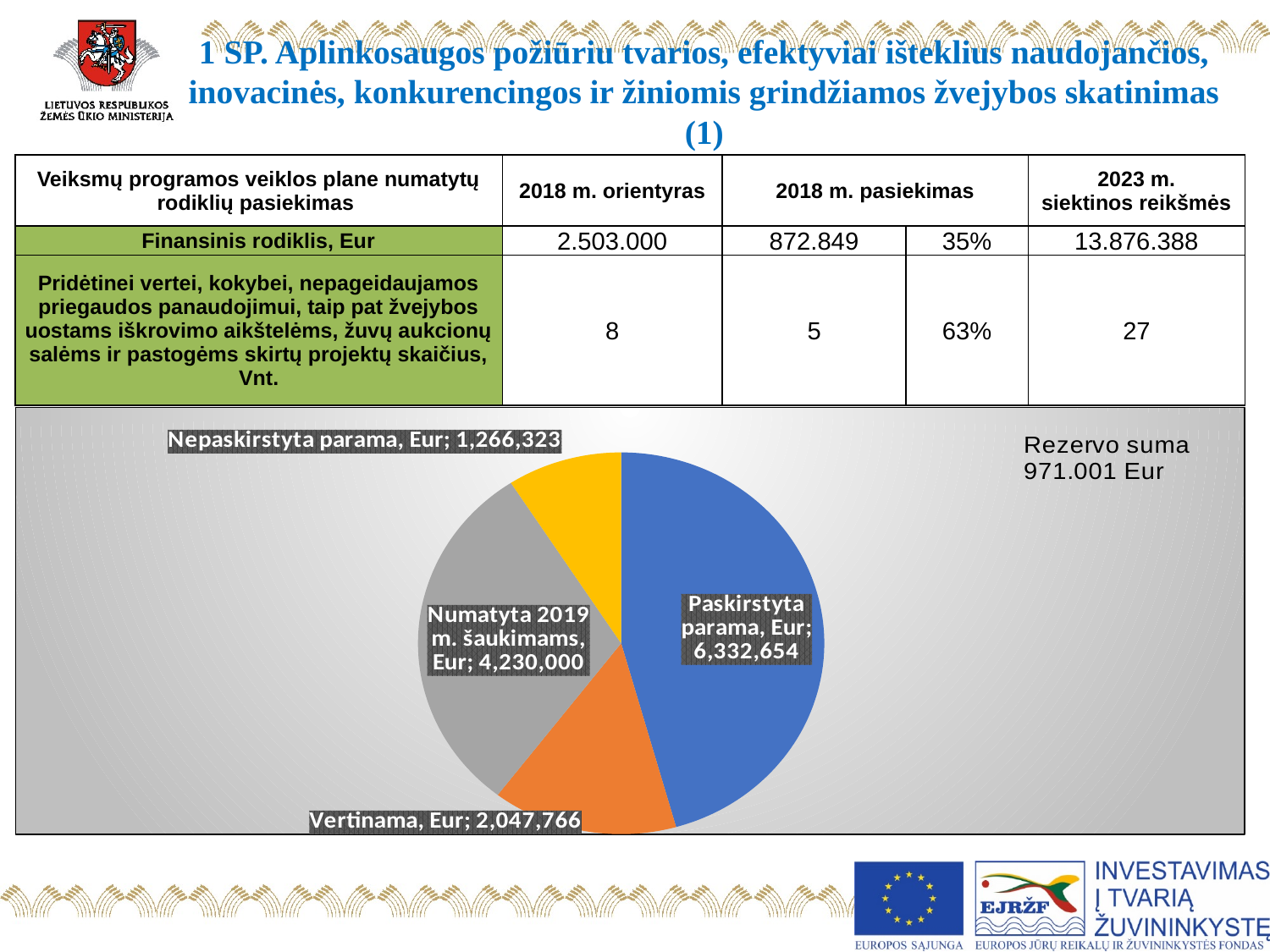
What is the value of the 'Nepaskirstyta parama, Eur' slice? 1,266,323 How many slices does the pie chart have? 4 What is the difference between the 'Paskirstyta parama, Eur' and 'Numatyta 2019 m. šaukimams, Eur' values? 2,102,654 Which is larger: 'Vertinama, Eur' or 'Nepaskirstyta parama, Eur'? Vertinama, Eur What is the total of all four slices in the pie chart? 13,876,743 Which slice of the pie chart has the smallest value? Nepaskirstyta parama, Eur What kind of chart is shown on the slide? pie chart What is the value of the 'Paskirstyta parama, Eur' slice? 6,332,654 Which slice of the pie chart has the largest value? Paskirstyta parama, Eur What colour is the 'Paskirstyta parama, Eur' slice? blue What is the value of the 'Numatyta 2019 m. šaukimams, Eur' slice? 4,230,000 What is the value of the 'Vertinama, Eur' slice? 2,047,766